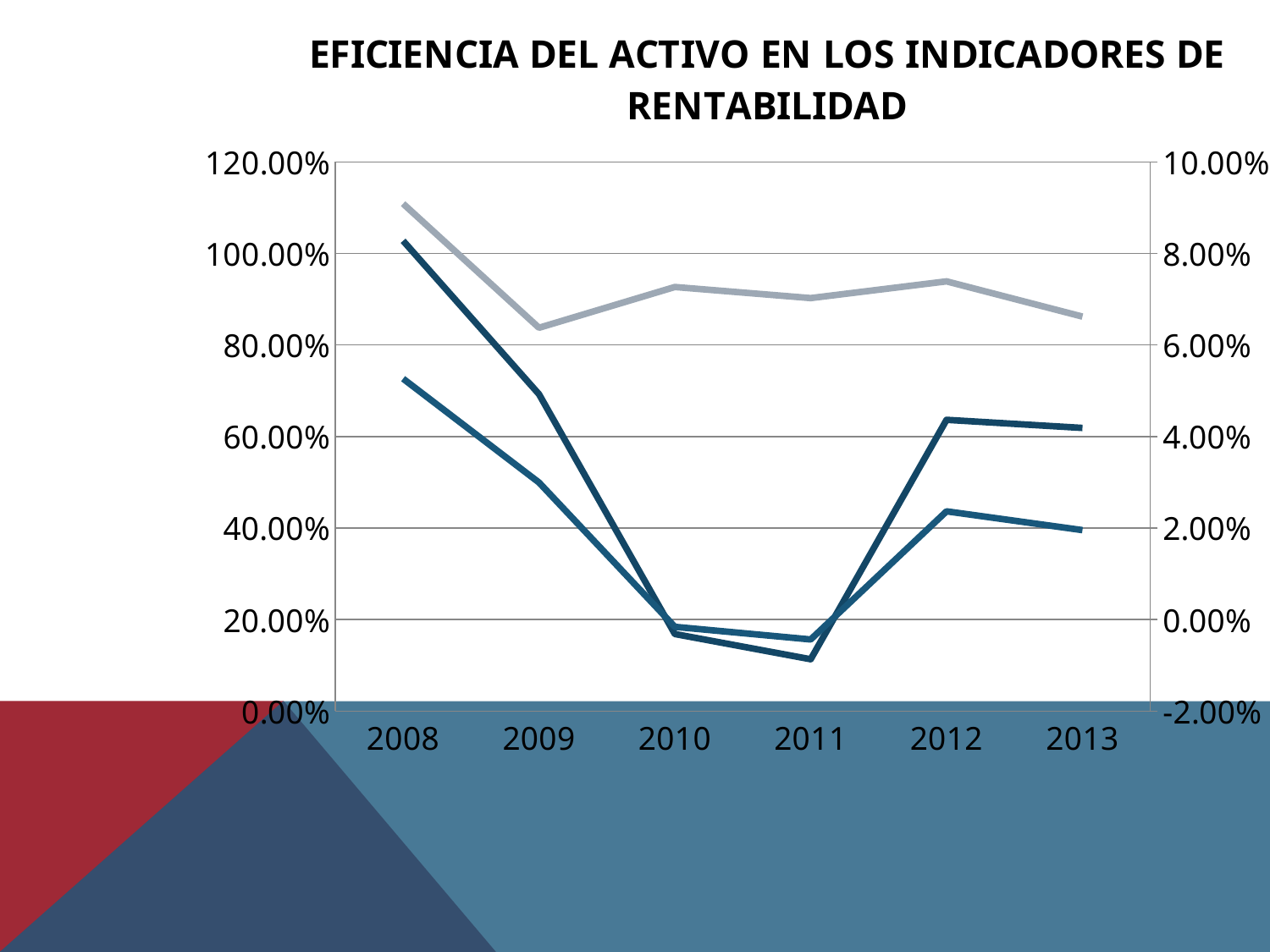
In which year does the dark navy line reach its highest point? 2008 How many lines are plotted on the chart? 3 In which year does the light grey line reach its highest point? 2008 Does the dark navy line rise or fall from 2011 to 2012? rise Which is the last year shown on the x axis? 2013 Does the light grey line rise or fall from 2008 to 2009? fall Which is the first year shown on the x axis? 2008 What kind of chart is shown on the slide? line chart What is the title of the chart? EFICIENCIA DEL ACTIVO EN LOS INDICADORES DE RENTABILIDAD How many years are shown on the x axis of the chart? 6 Does the dark navy line rise or fall from 2008 to 2011? fall In which year does the dark navy line reach its lowest point? 2011